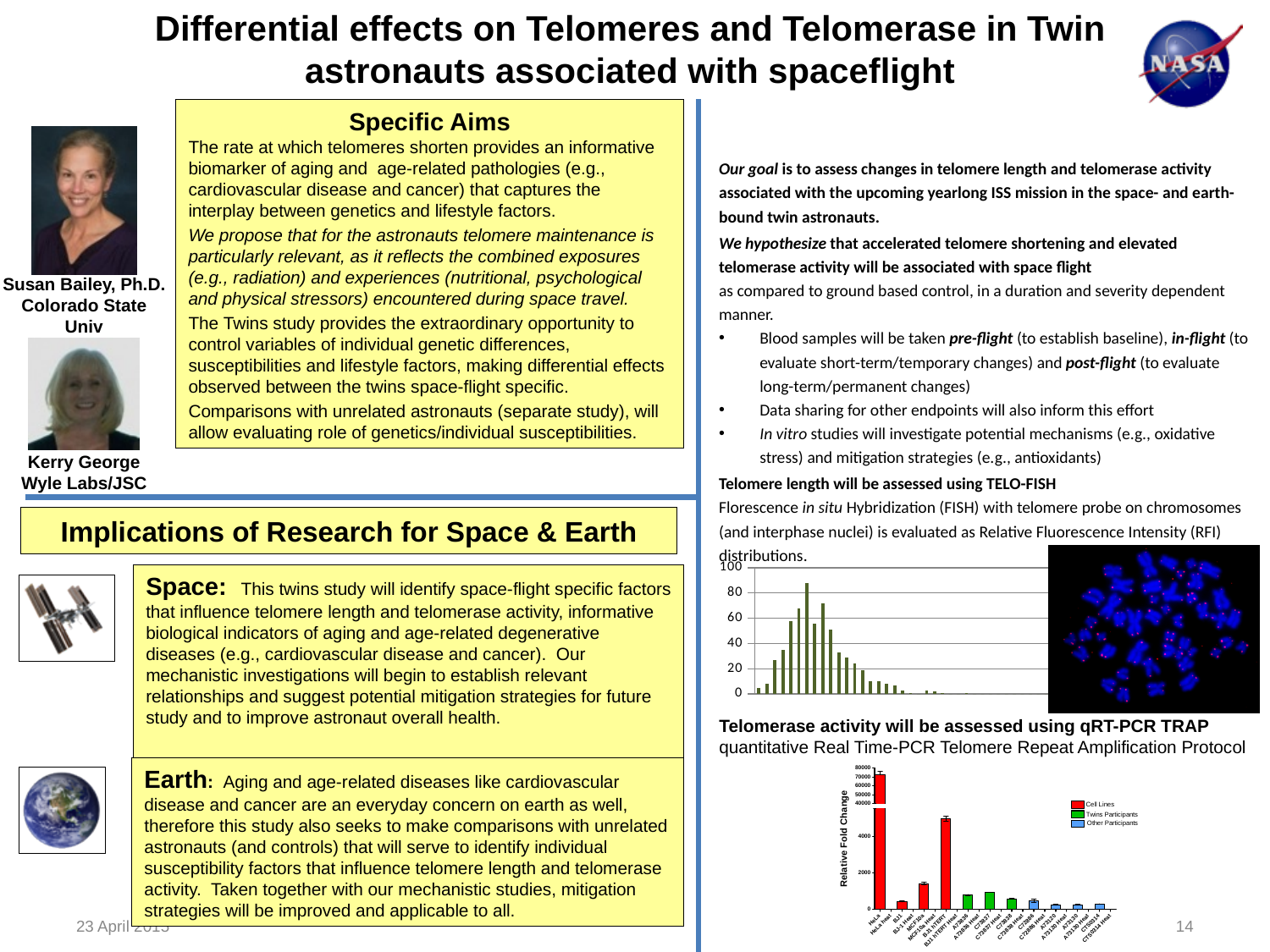
What kind of chart is the chart below the text 'Telomerase activity will be assessed using qRT-PCR TRAP'? bar chart In the RFI distribution bar chart next to the chromosome image, is the tallest bar greater or less than 80? greater How many series does the legend of the Relative Fold Change bar chart list? 3 In the Relative Fold Change bar chart, which series is shown in red? Cell Lines What are the three legend entries of the Relative Fold Change bar chart? Cell Lines, Twins Participants, Other Participants What kind of chart is the chart next to the chromosome image, under the text about RFI distributions? bar chart What is the y-axis label of the bar chart at the bottom right of the slide? Relative Fold Change In the RFI distribution bar chart next to the chromosome image, is the first bar on the left greater or less than 20? less In the Relative Fold Change bar chart, is the tallest bar greater or less than 60000? greater